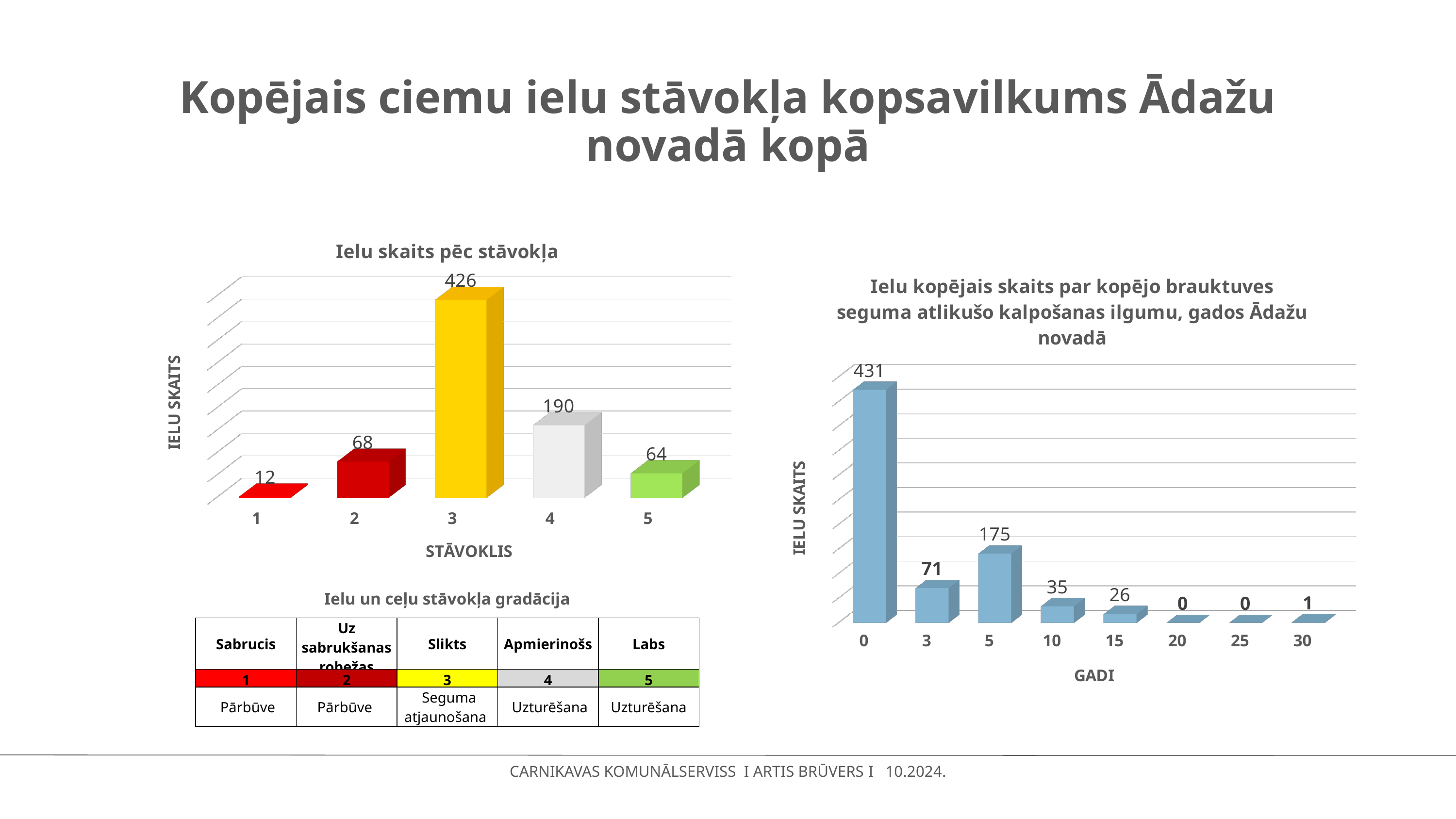
In the chart 'Ielu skaits pēc stāvokļa', what is the x-axis title? STĀVOKLIS In the chart 'Ielu skaits pēc stāvokļa', what is the difference between the values for condition 4 and condition 2? 122 In the right-hand chart (Ielu kopējais skaits par kopējo brauktuves seguma atlikušo kalpošanas ilgumu), what is the value for 0 years? 431 In the chart 'Ielu skaits pēc stāvokļa', which condition category has the highest value? 3 In the right-hand chart (Ielu kopējais skaits par kopējo brauktuves seguma atlikušo kalpošanas ilgumu), what is the value for 5 years? 175 In the right-hand chart (Ielu kopējais skaits par kopējo brauktuves seguma atlikušo kalpošanas ilgumu), how many year categories are shown on the x axis? 8 In the chart 'Ielu skaits pēc stāvokļa', how many condition categories are shown on the x axis? 5 In the chart 'Ielu skaits pēc stāvokļa', what is the value for condition 1? 12 In the right-hand chart (Ielu kopējais skaits par kopējo brauktuves seguma atlikušo kalpošanas ilgumu), which of 3 years or 10 years has the larger value? 3 What kind of chart is the right-hand chart (Ielu kopējais skaits par kopējo brauktuves seguma atlikušo kalpošanas ilgumu)? Bar chart In the chart 'Ielu skaits pēc stāvokļa', what is the value for condition 3? 426 In the chart 'Ielu skaits pēc stāvokļa', which condition category has the lowest value? 1